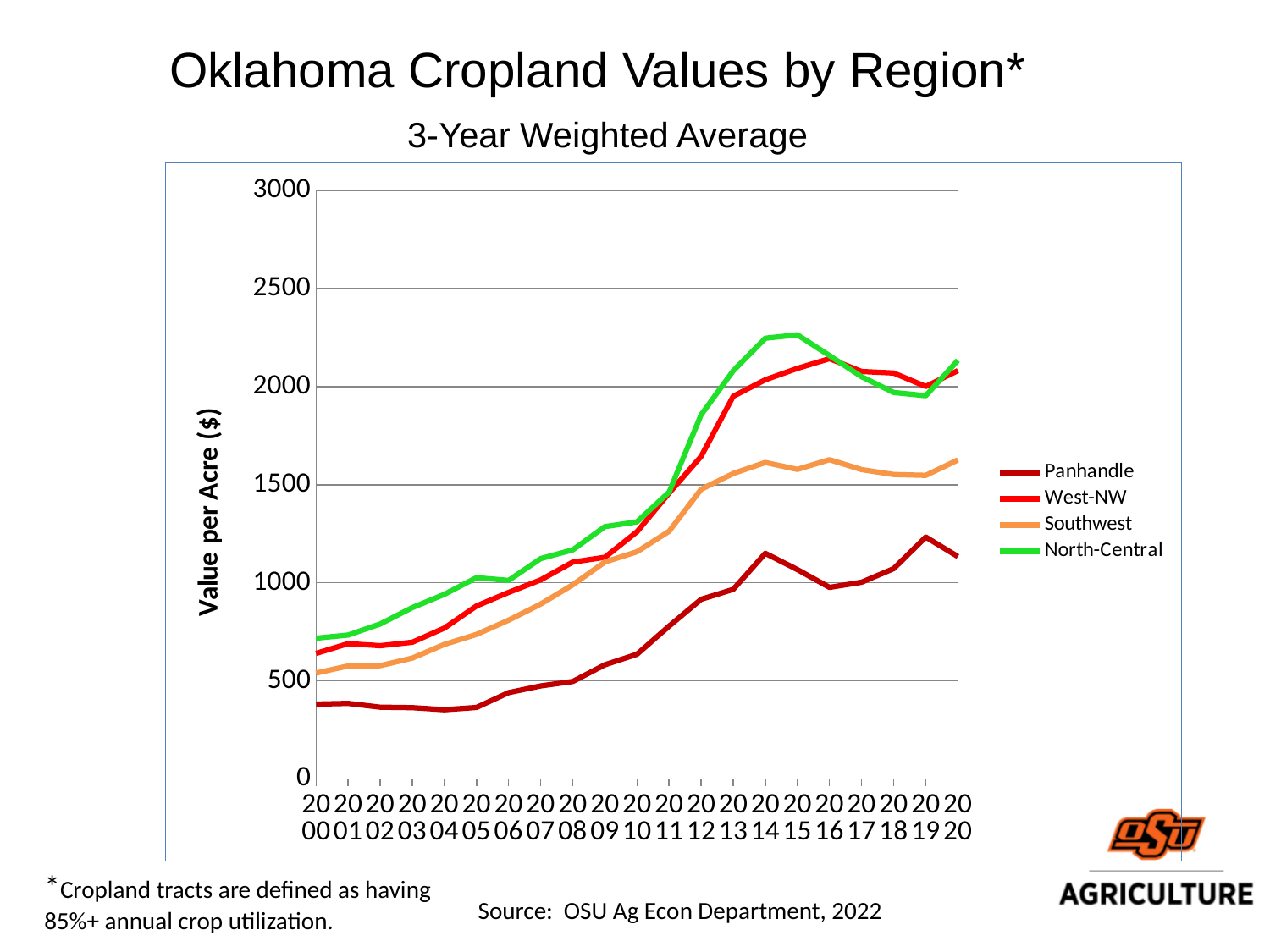
What is the label on the y axis? Value per Acre ($) Is the value for Panhandle in 2000 greater or less than 500? less What kind of chart is shown on the slide? line chart Is the value for Southwest in 2020 greater or less than 2000? less Is the value for West-NW in 2010 greater or less than 1500? less Which region has the lowest value in 2020? Panhandle In 2014, which is higher: North-Central or West-NW? North-Central Which region has the highest value in 2015? North-Central How many series does the legend list? 4 Does the Panhandle line generally rise or fall from 2000 to 2014? rise How many years are plotted along the x axis? 21